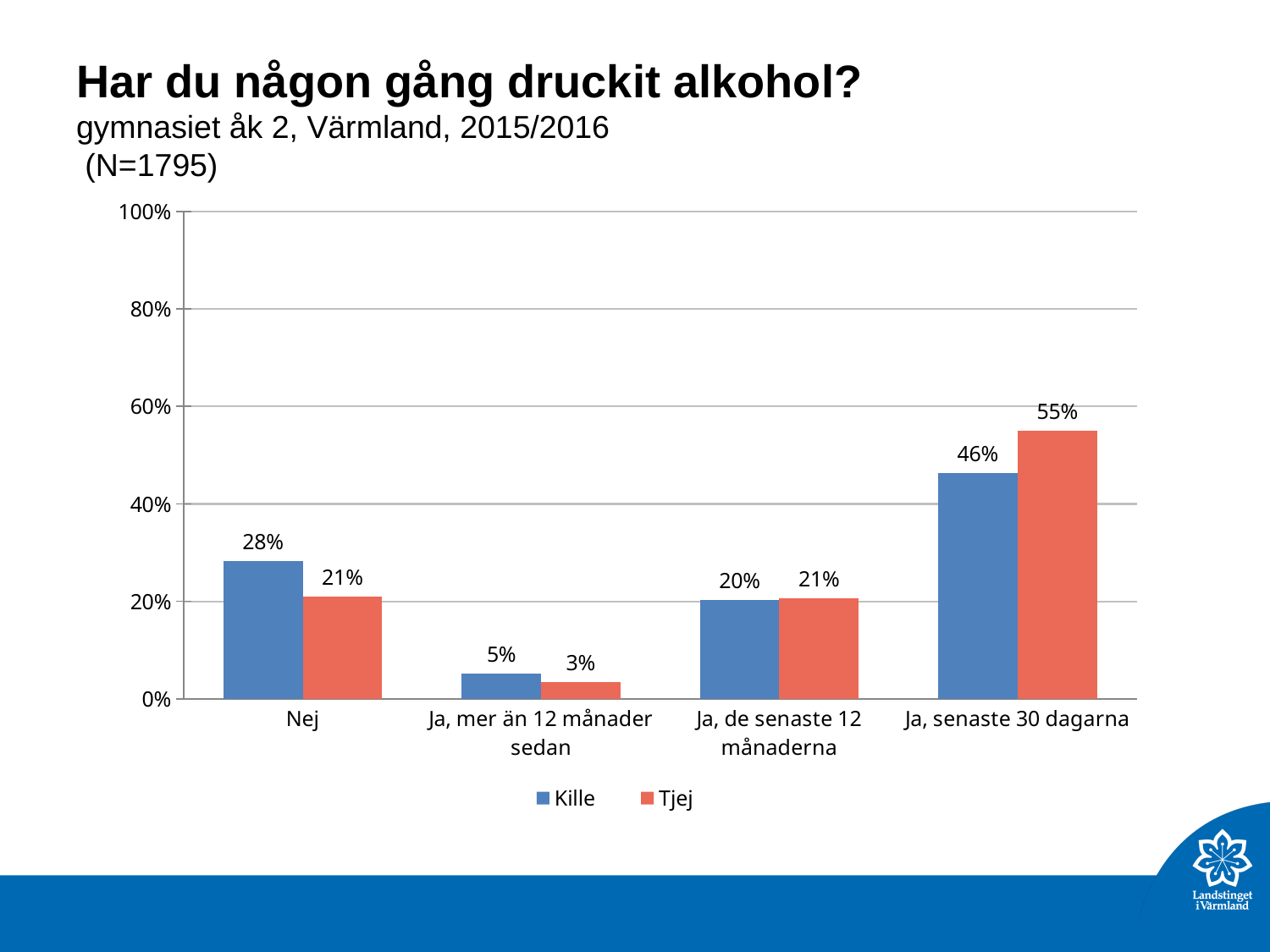
What is the sample size (N) stated in the chart title? 1795 What is the value for Tjej in the "Ja, mer än 12 månader sedan" category? 3% Which category has the lowest value for Tjej? Ja, mer än 12 månader sedan What is the value for Kille in the "Nej" category? 28% How many series does the legend list? 2 Is the value for Kille in the "Ja, senaste 30 dagarna" category greater or less than 40%? greater How many categories are shown on the x axis? 4 What kind of chart is shown on the slide? Bar chart What is the value for Tjej in the "Ja, senaste 30 dagarna" category? 55% Which category has the highest value for Kille? Ja, senaste 30 dagarna What is the difference between the Tjej and Kille values in the "Ja, senaste 30 dagarna" category? 9% In the "Nej" category, which series has the larger value, Kille or Tjej? Kille